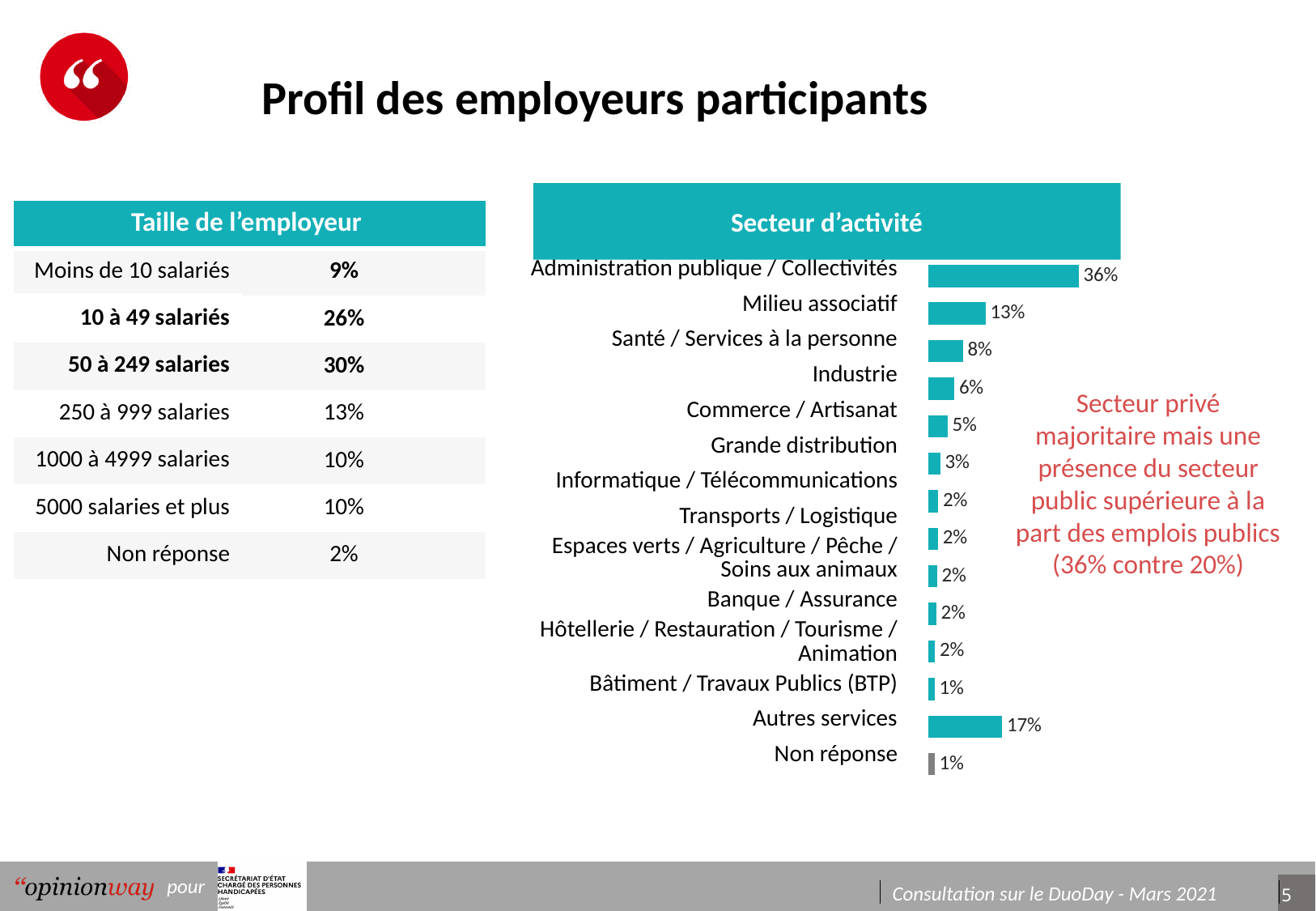
In the 'Secteur d'activité' chart, what is the value for Administration publique / Collectivités? 36% In the 'Secteur d'activité' chart, what is the difference between Administration publique / Collectivités and Autres services? 19% In the 'Secteur d'activité' chart, which sector has the highest value? Administration publique / Collectivités In the 'Secteur d'activité' chart, what is the difference between Milieu associatif and Santé / Services à la personne? 5% In the 'Secteur d'activité' chart, what is the value for Industrie? 6% What type of chart is the 'Secteur d'activité' chart? Bar chart What is the title of the bar chart on the slide? Secteur d'activité How many categories are shown in the 'Secteur d'activité' chart? 14 In the 'Secteur d'activité' chart, what is the value for Autres services? 17% In the 'Secteur d'activité' chart, what is the value for Bâtiment / Travaux Publics (BTP)? 1% In the 'Secteur d'activité' chart, what is the value for Milieu associatif? 13% In the 'Secteur d'activité' chart, which is larger: Commerce / Artisanat or Grande distribution? Commerce / Artisanat